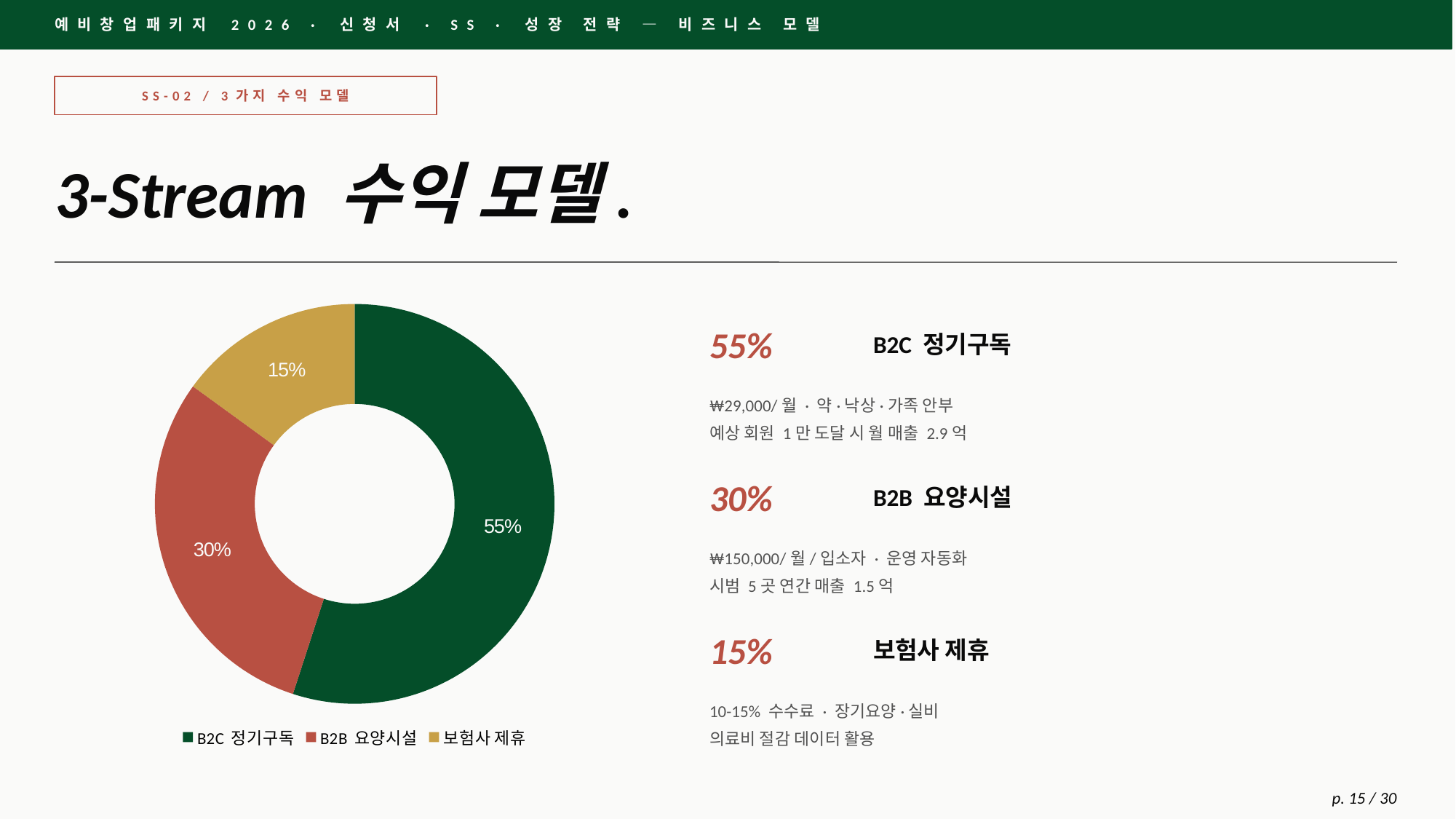
Which category has the largest slice in the chart? B2C 정기구독 How many categories are shown in the chart? 3 What is the difference in percentage points between B2C 정기구독 and B2B 요양시설? 25 What share of the chart does B2C 정기구독 represent? 55% What kind of chart is shown on the slide? Doughnut chart Which is larger, the slice for B2B 요양시설 or the slice for 보험사 제휴? B2B 요양시설 How many entries does the chart legend list? 3 What share of the chart does 보험사 제휴 represent? 15% Which category has the smallest slice in the chart? 보험사 제휴 What colour is the slice for B2B 요양시설? Red What is the difference in percentage points between B2B 요양시설 and 보험사 제휴? 15 What share of the chart does B2B 요양시설 represent? 30%